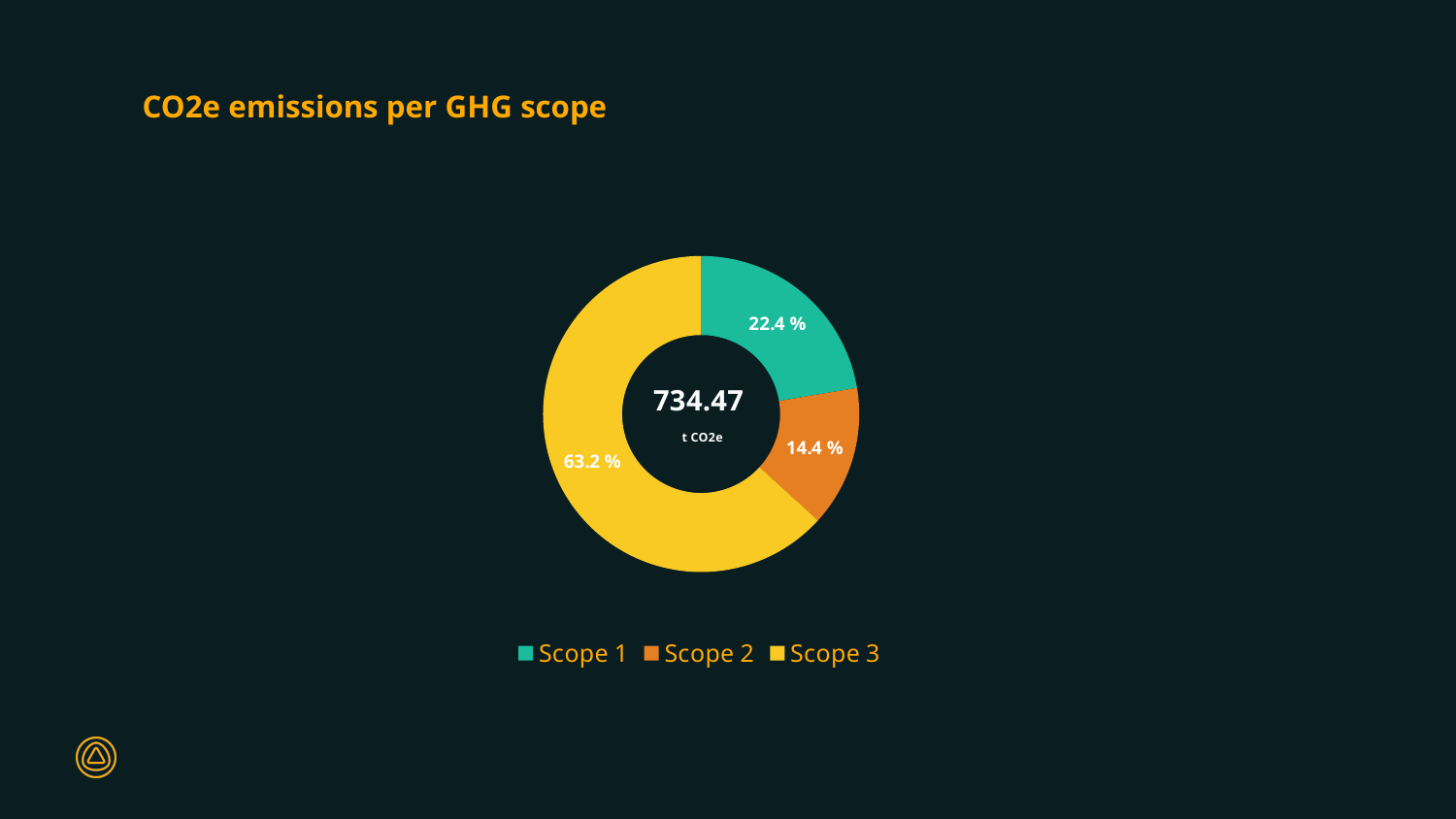
What share of CO2e emissions does Scope 3 account for? 63.2 % What share of CO2e emissions does Scope 2 account for? 14.4 % What kind of chart is shown on the slide? Pie (doughnut) chart What is the difference in percentage points between the Scope 3 share and the Scope 1 share? 40.8 percentage points How many scopes are shown in the chart? 3 Which has a larger share of emissions, Scope 1 or Scope 2? Scope 1 What is the total CO2e emissions figure shown in the centre of the chart? 734.47 t CO2e What share of CO2e emissions does Scope 1 account for? 22.4 % Which scope has the smallest share of CO2e emissions? Scope 2 What is the title of the chart? CO2e emissions per GHG scope Which colour represents Scope 3 in the chart? Yellow Which scope has the largest share of CO2e emissions? Scope 3